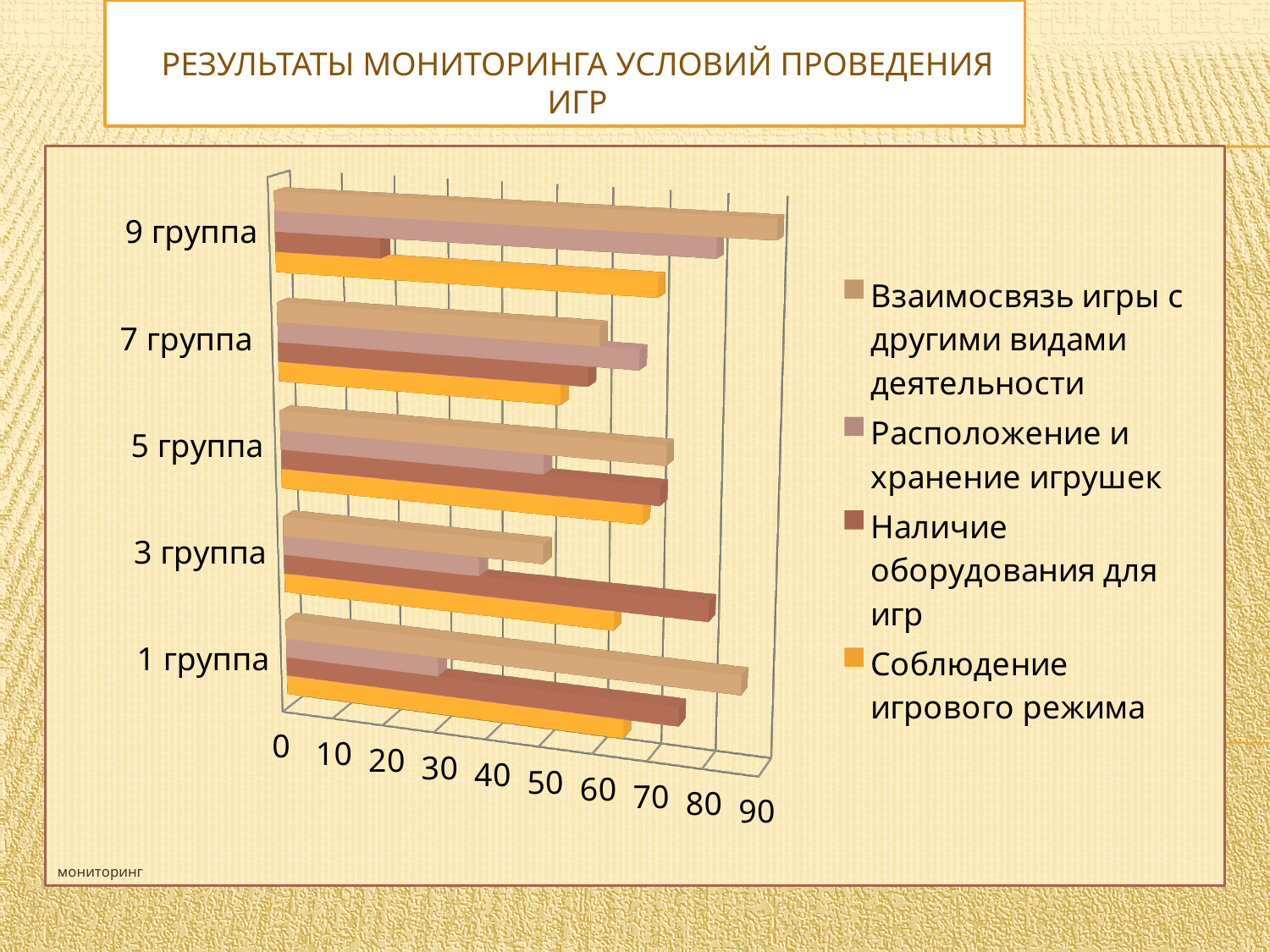
What colour represents "Соблюдение игрового режима" in the legend? orange Which group has the lowest value for "Наличие оборудования для игр"? 9 группа What kind of chart is shown on the slide? bar chart Is the value of "Расположение и хранение игрушек" for 1 группа greater or less than 40? less Is the value of "Наличие оборудования для игр" for 9 группа greater or less than 30? less For 9 группа, which is larger: "Взаимосвязь игры с другими видами деятельности" or "Наличие оборудования для игр"? Взаимосвязь игры с другими видами деятельности How many series does the chart legend list? 4 Is the value of "Взаимосвязь игры с другими видами деятельности" for 9 группа greater or less than 80? greater How many groups (categories) are shown on the chart? 5 For 3 группа, which is larger: "Наличие оборудования для игр" or "Расположение и хранение игрушек"? Наличие оборудования для игр Which group has the highest value for "Расположение и хранение игрушек"? 9 группа